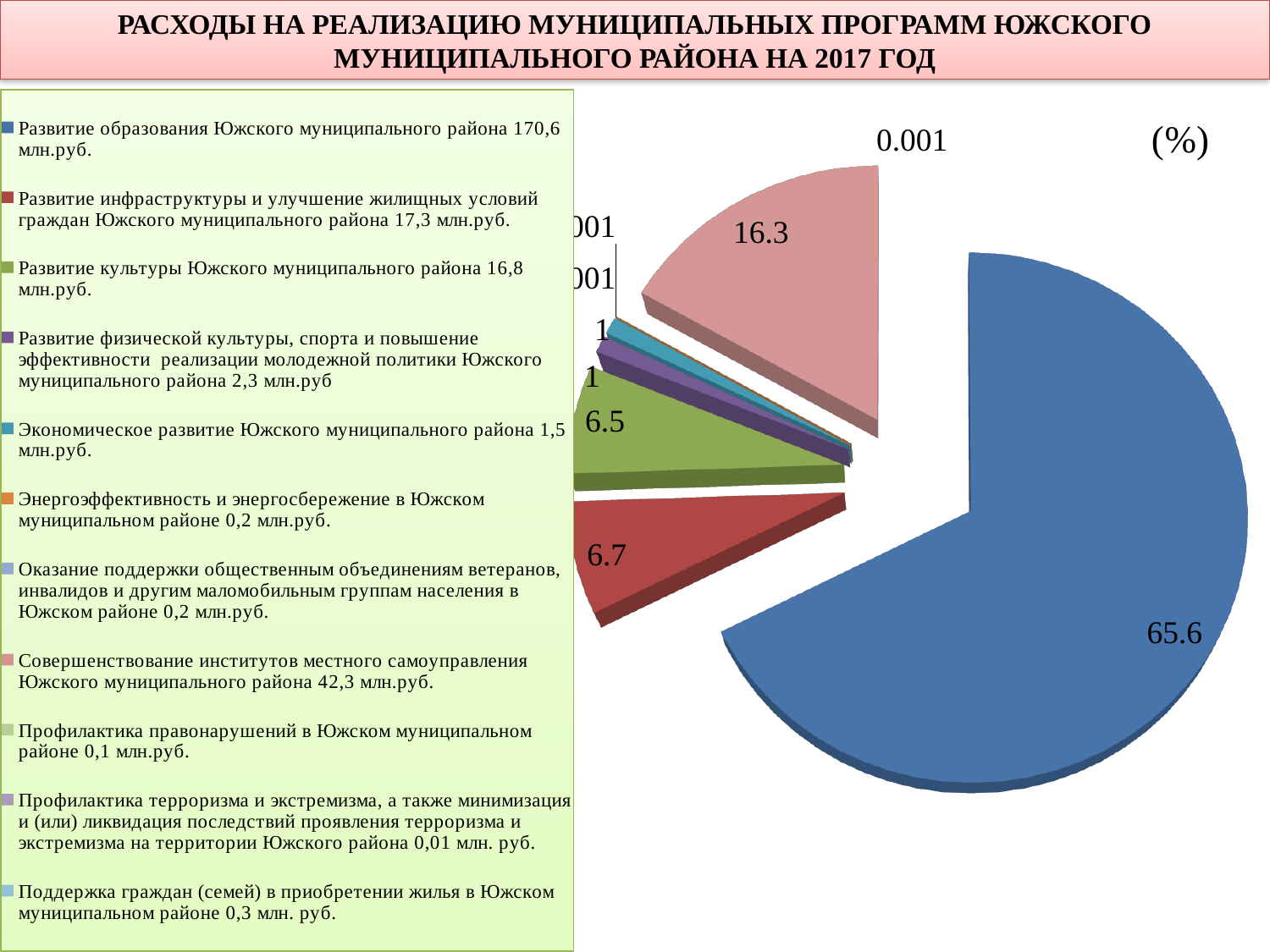
Which programme has the largest slice of the pie chart? Развитие образования Южского муниципального района What kind of chart is shown on the slide? pie chart What percentage share is labelled on the largest (blue) slice of the pie chart? 65.6 According to the legend, how much is allocated to Развитие образования Южского муниципального района? 170,6 млн.руб. What percentage is labelled on the pink slice for Совершенствование институтов местного самоуправления? 16.3 Is the share of the blue slice greater or less than 50%? greater What unit is indicated in the top-right corner of the pie chart? (%) According to the legend, how much is allocated to Совершенствование институтов местного самоуправления Южского муниципального района? 42,3 млн.руб. Which slice is larger: the red one labelled 6.7 or the green one labelled 6.5? the red one (6.7) What is the difference between the 65.6 slice and the 16.3 slice in the pie chart? 49.3 What year does the slide title say the expenditures refer to? 2017 How many entries does the legend of the pie chart list? 11